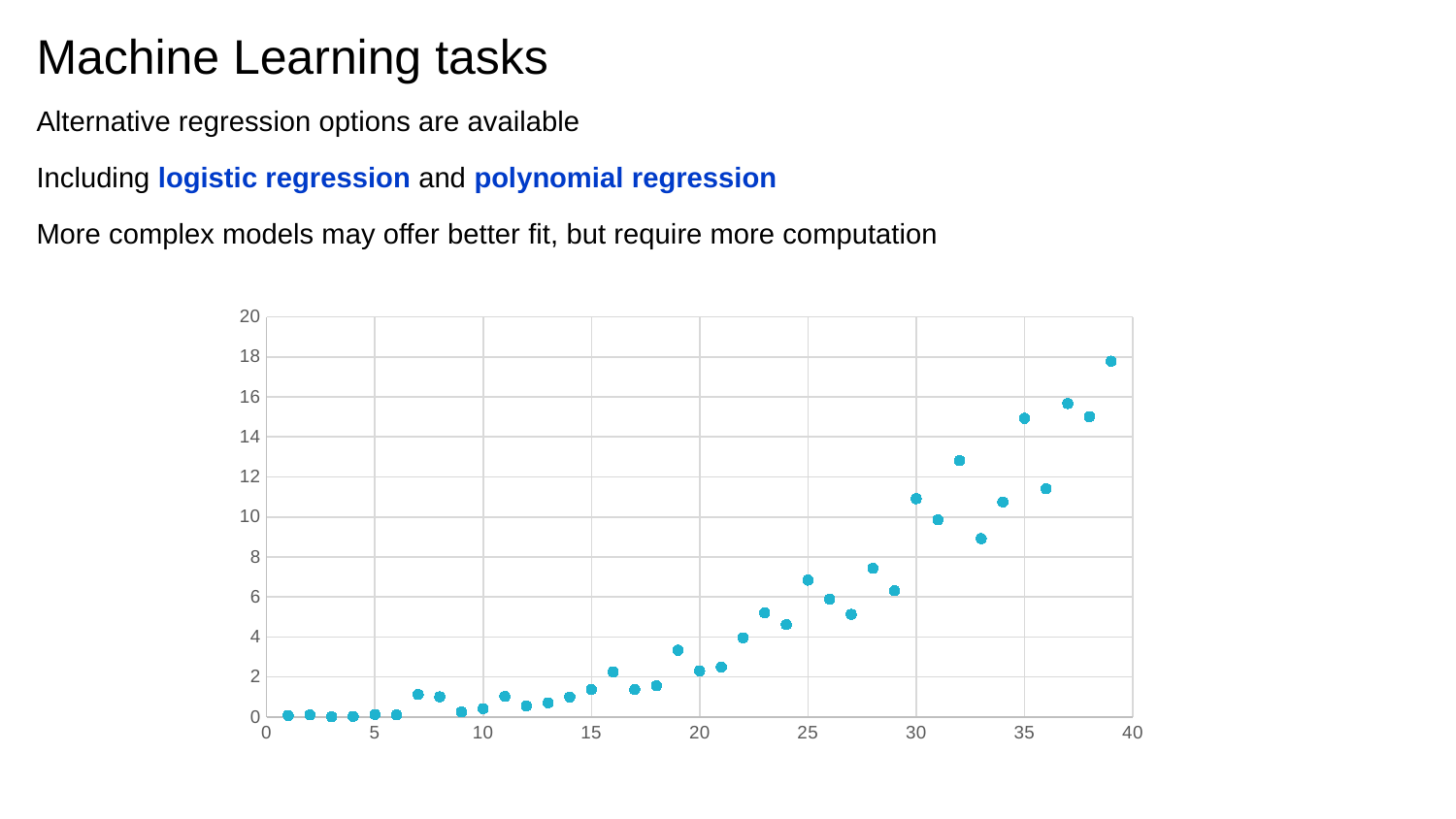
Is the value at x = 25 greater or less than 5? greater Is the value at x = 39 greater or less than 16? greater Which has the larger value, the point at x = 32 or the point at x = 33? x = 32 Is the value at x = 37 greater or less than 14? greater Do the plotted values generally rise or fall as x increases from 0 to 40? rise What is the maximum value shown on the y axis? 20 What kind of chart is shown on the slide? scatter plot At which x value is the highest point plotted? 39 Which has the larger value, the point at x = 27 or the point at x = 28? x = 28